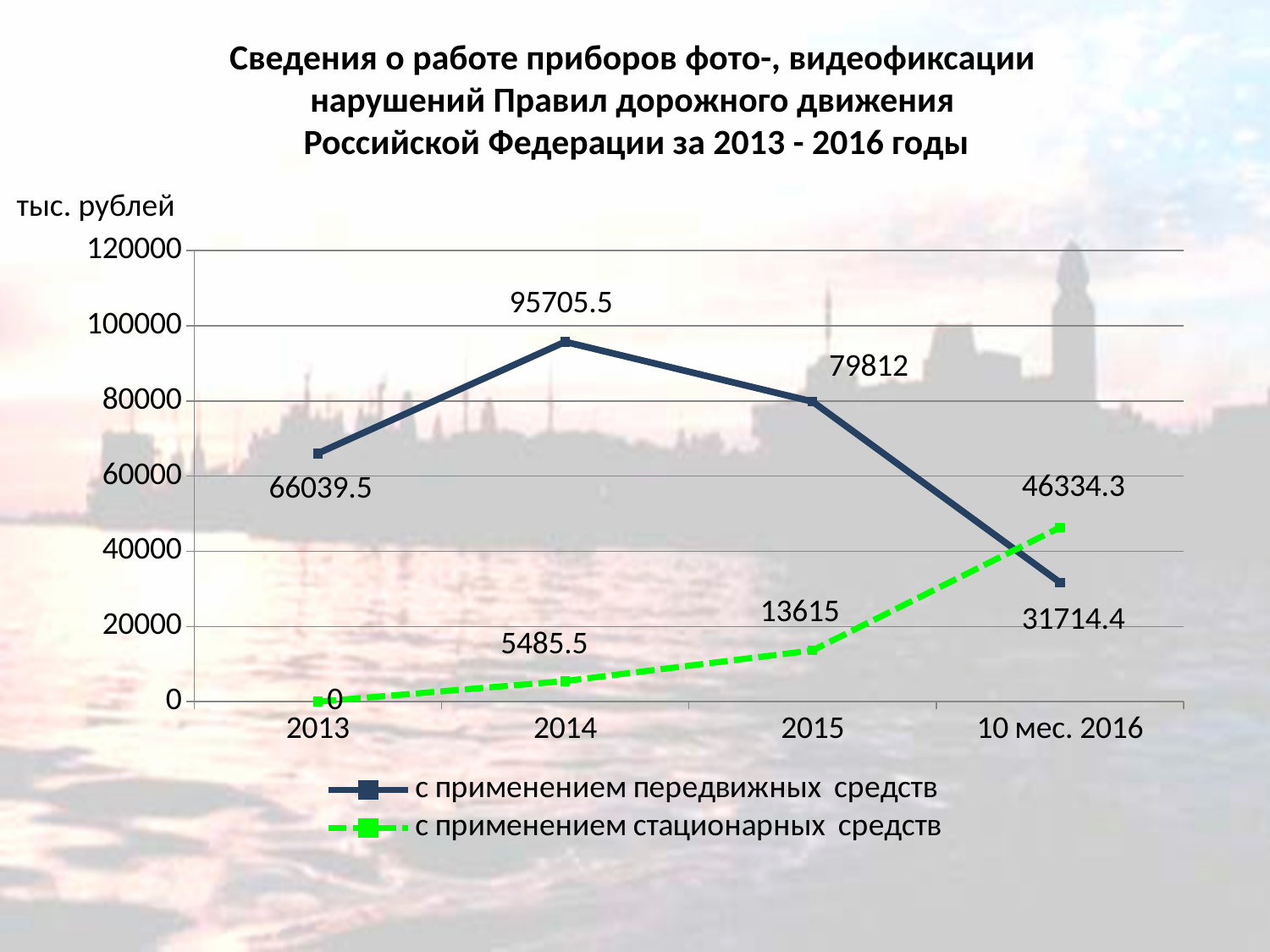
What is the value for 'с применением стационарных средств' in 2015? 13615 How many series does the legend list? 2 What is the value for 'с применением стационарных средств' in 2013? 0 For '10 мес. 2016', which series has the larger value: 'с применением передвижных средств' or 'с применением стационарных средств'? с применением стационарных средств What is the value for 'с применением передвижных средств' for '10 мес. 2016'? 31714.4 What is the value for 'с применением передвижных средств' in 2014? 95705.5 In which period is the value for 'с применением стационарных средств' lowest? 2013 How many periods are shown on the x axis? 4 Does the value for 'с применением стационарных средств' rise or fall from 2013 to '10 мес. 2016'? rise In which period is the value for 'с применением передвижных средств' highest? 2014 What is the difference between the 2014 and 2015 values for 'с применением передвижных средств'? 15893.5 What type of chart is shown on the slide? line chart